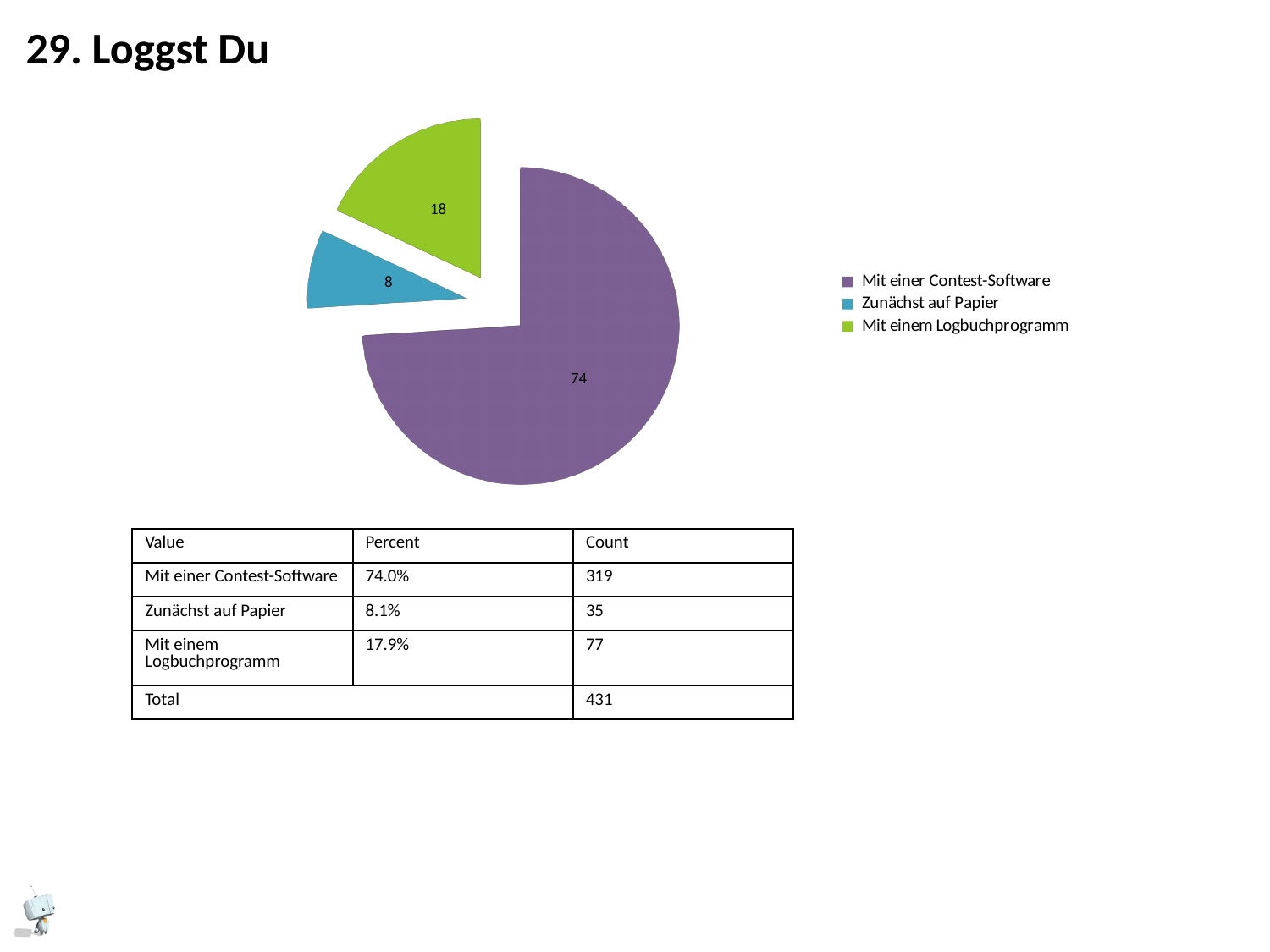
What is the difference between the labelled values for Mit einer Contest-Software and Mit einem Logbuchprogramm? 56 Which category has the smallest slice of the pie? Zunächst auf Papier What colour is the slice for Mit einem Logbuchprogramm? green What value is labelled on the pie slice for Mit einer Contest-Software? 74 What kind of chart is shown on the slide? pie chart Which slice is larger, Zunächst auf Papier or Mit einem Logbuchprogramm? Mit einem Logbuchprogramm Which category has the largest slice of the pie? Mit einer Contest-Software How many slices does the pie chart have? 3 What value is labelled on the pie slice for Mit einem Logbuchprogramm? 18 How many entries does the legend of the pie chart list? 3 What is the difference between the labelled values for Mit einem Logbuchprogramm and Zunächst auf Papier? 10 What value is labelled on the pie slice for Zunächst auf Papier? 8